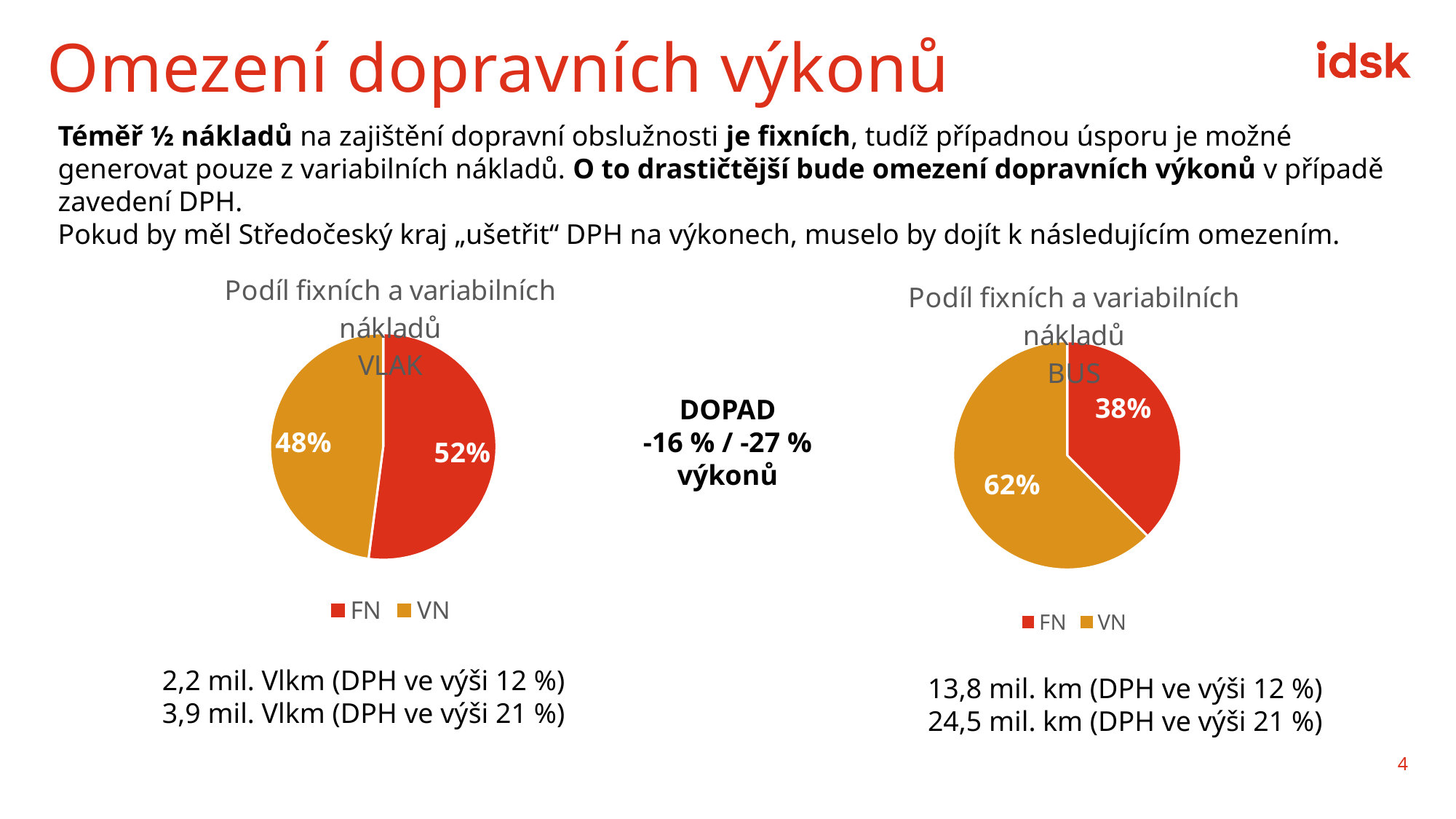
In the VLAK pie chart on the left, what colour is the VN slice? Orange In the BUS pie chart on the right, what share does FN have? 38% What type of chart is the chart on the left of the slide? Pie chart In the VLAK pie chart on the left, what share does VN have? 48% In the VLAK pie chart on the left, what share does FN have? 52% In the VLAK pie chart on the left, which slice is larger, FN or VN? FN In the VLAK pie chart on the left, what is the difference between the FN and VN shares? 4% In the BUS pie chart on the right, which slice is the largest? VN In the BUS pie chart on the right, what is the difference between the VN and FN shares? 24% In the BUS pie chart on the right, what share does VN have? 62% In the BUS pie chart on the right, which slice is the smallest? FN How many series does the legend of the BUS pie chart on the right list? 2